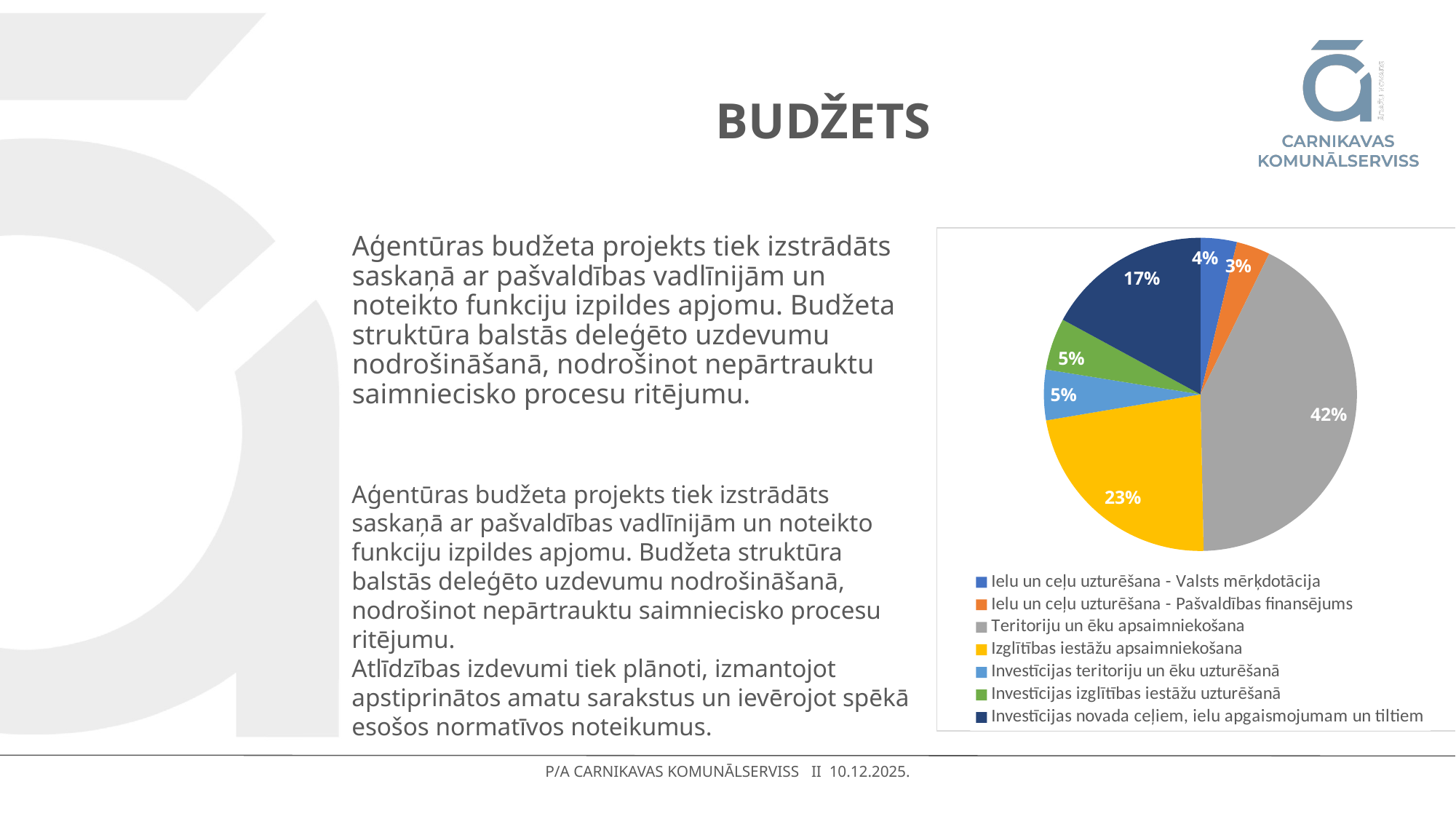
What is the value for "Ielu un ceļu uzturēšana - Pašvaldības finansējums"? 3% How many categories does the pie chart have? 7 Which category has the largest slice of the pie? Teritoriju un ēku apsaimniekošana What share of the pie does "Investīcijas novada ceļiem, ielu apgaismojumam un tiltiem" have? 17% What share of the pie does "Izglītības iestāžu apsaimniekošana" have? 23% What is the difference between the shares of "Teritoriju un ēku apsaimniekošana" and "Izglītības iestāžu apsaimniekošana"? 19% What kind of chart is shown on the slide? pie chart What share of the pie does "Teritoriju un ēku apsaimniekošana" have? 42% Which is larger: the share for "Investīcijas novada ceļiem, ielu apgaismojumam un tiltiem" or for "Izglītības iestāžu apsaimniekošana"? Izglītības iestāžu apsaimniekošana What is the value for "Ielu un ceļu uzturēšana - Valsts mērķdotācija"? 4% What colour is the slice for "Izglītības iestāžu apsaimniekošana"? yellow Which category has the smallest slice of the pie? Ielu un ceļu uzturēšana - Pašvaldības finansējums